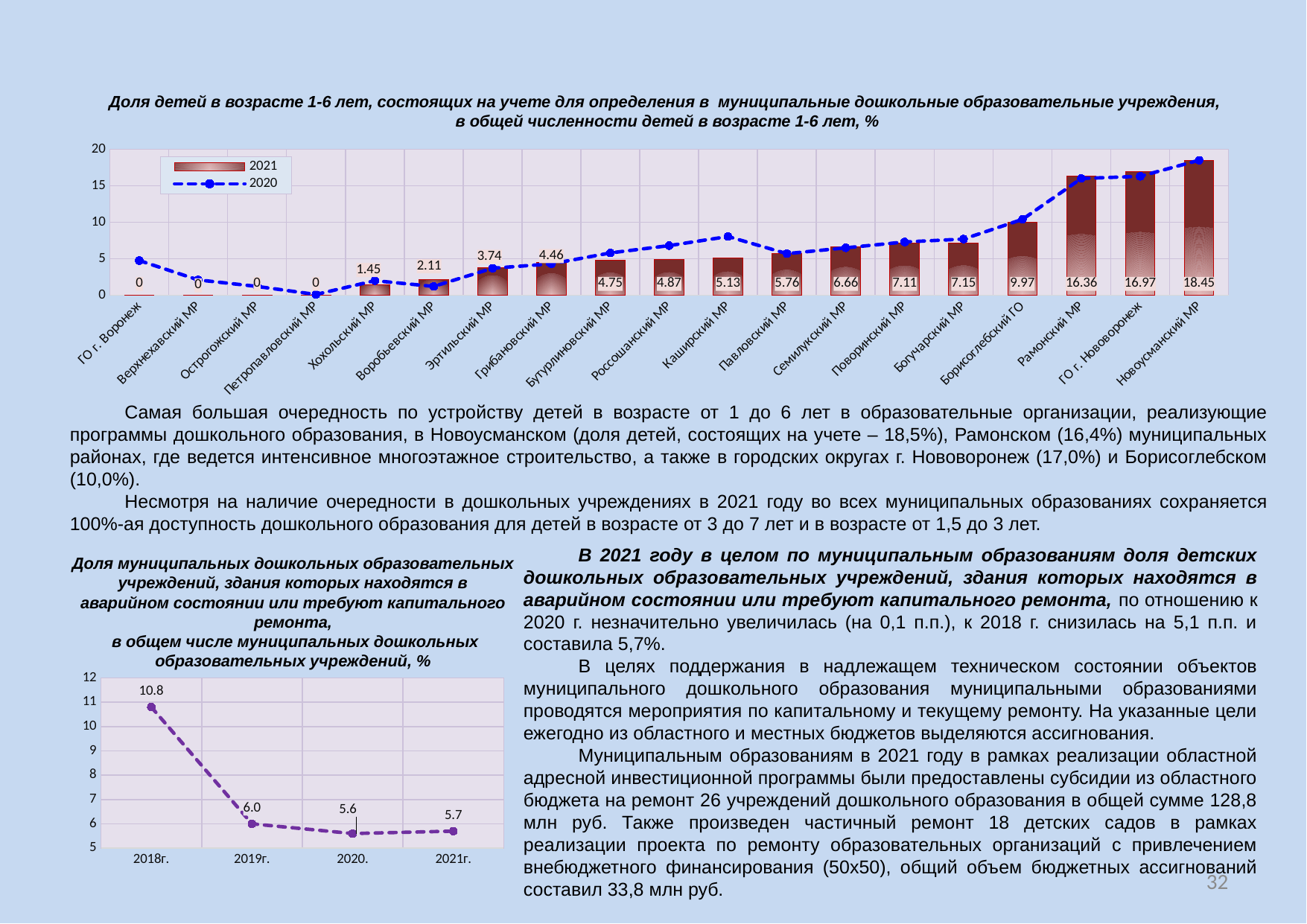
In the top chart, what is the 2021 value for Новоусманский МР? 18.45 In the top chart, what is the difference between the 2021 values for ГО г. Нововоронеж and Рамонский МР? 0.61 In the top chart, is the 2020 value for Каширский МР greater or less than 5? greater In the bottom chart, which year has the lowest value? 2020. In the top chart, which series is shown as a dashed line with markers? 2020 How many series does the legend of the top chart list? 2 In the bottom chart, what is the value for 2018г.? 10.8 In the top chart, what is the 2021 value for Борисоглебский ГО? 9.97 How many municipalities are shown on the x axis of the top chart? 19 In the top chart, which has a larger 2021 value: Семилукский МР or Павловский МР? Семилукский МР In the top chart, which municipality has the highest 2021 value? Новоусманский МР What type of chart is the bottom chart? line chart